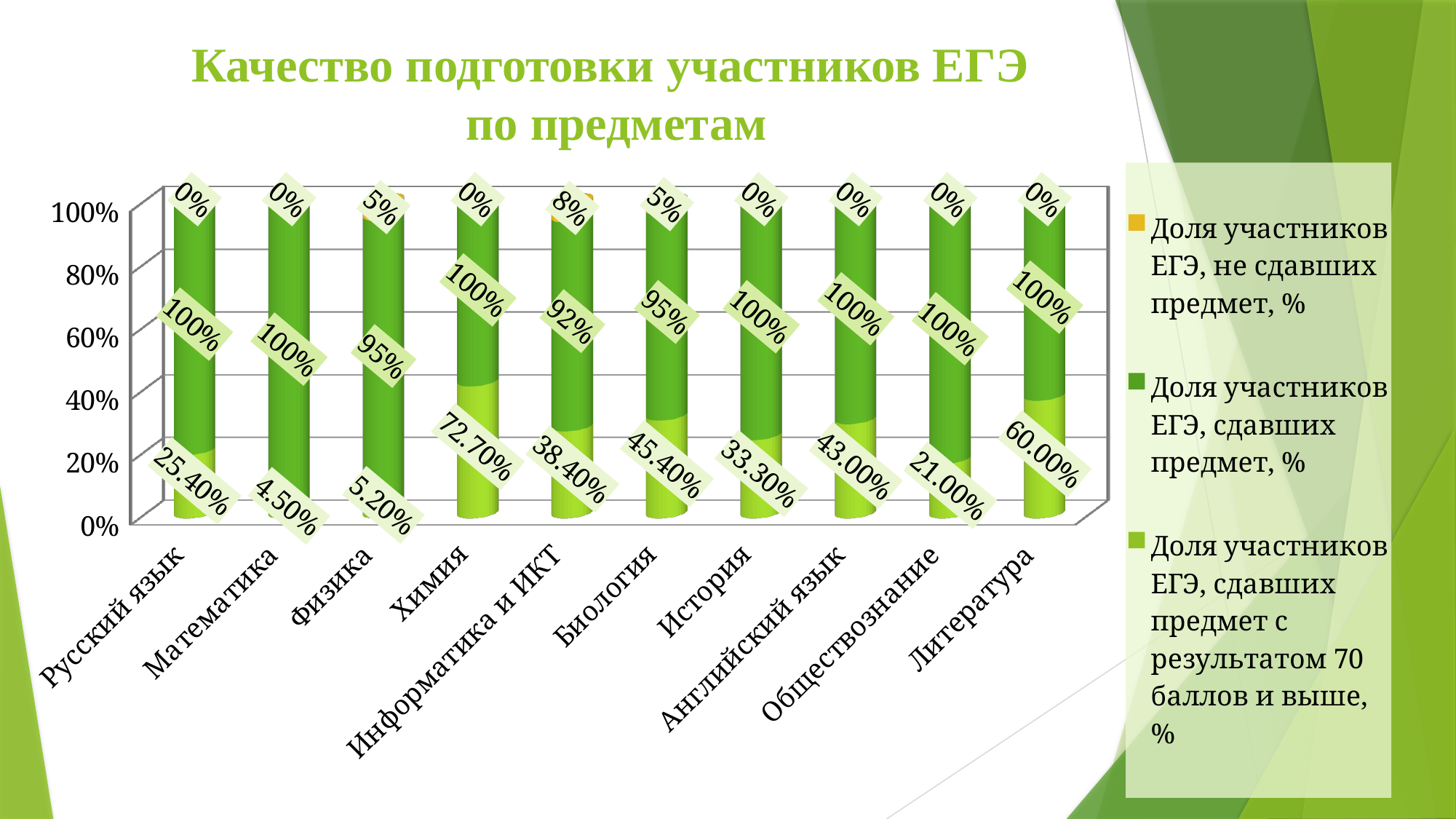
Which subject has the lowest share of participants with a result of 70 points or higher? Математика What is the difference between the share of participants with 70 points or higher in Литература and in Обществознание? 39.00% Which subject has a larger share of participants with 70 points or higher, Английский язык or История? Английский язык What is the share of participants who passed Биология? 95% How many series does the legend list? 3 What is the share of participants who passed Химия with a result of 70 points or higher? 72.70% How many subjects are shown on the chart? 10 What kind of chart is shown on the slide? Bar chart What is the share of participants who did not pass Информатика и ИКТ? 8% Which subject has the highest share of participants with a result of 70 points or higher? Химия What is the share of participants who passed Математика with a result of 70 points or higher? 4.50% What is the title of the chart on the slide? Качество подготовки участников ЕГЭ по предметам